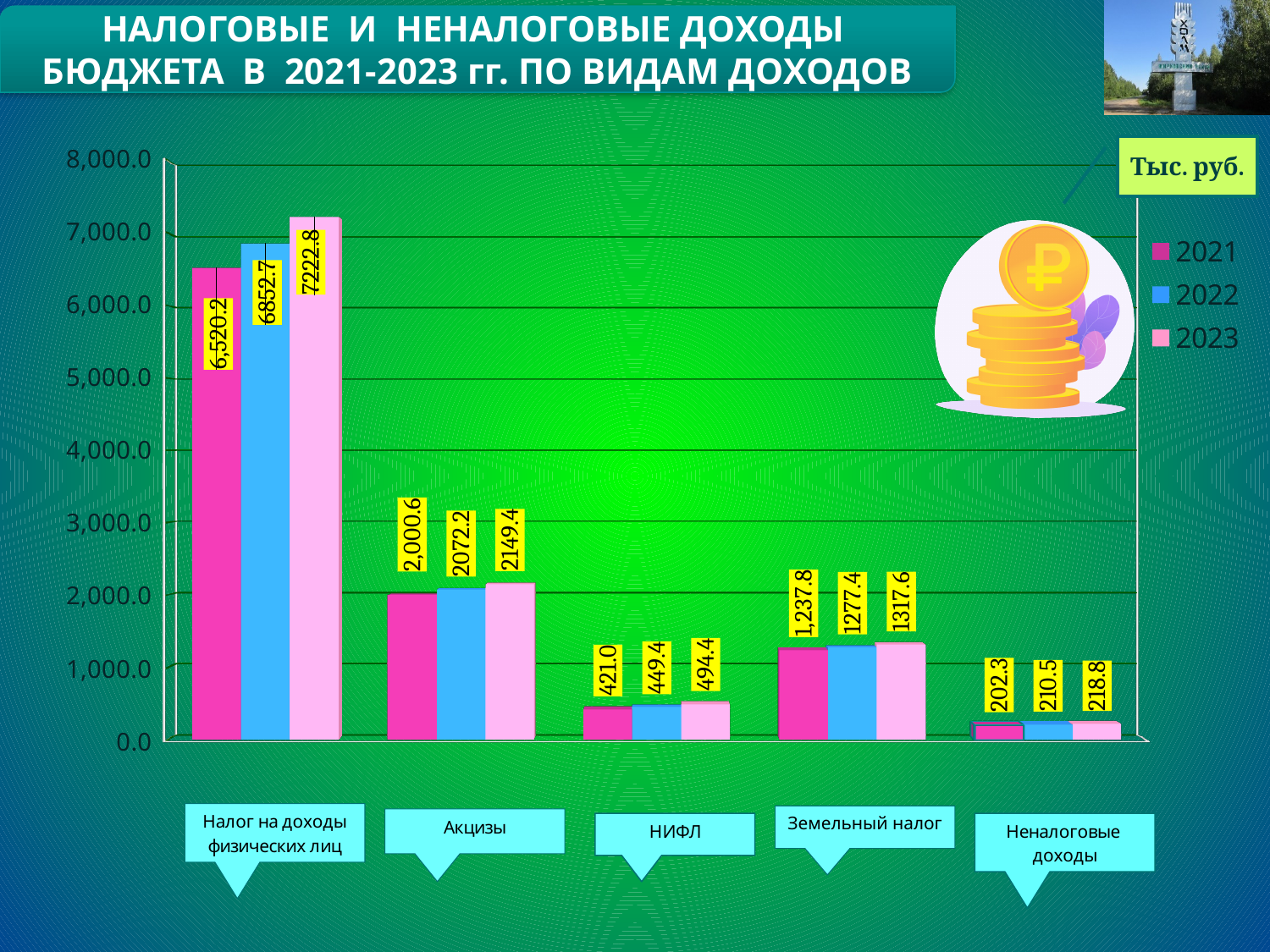
Which category has the lowest value in 2023? Неналоговые доходы How many series does the legend list? 3 What is the value for Неналоговые доходы in 2021? 202.3 How many categories are shown on the x axis? 5 What is the value for Акцизы in 2021? 2,000.6 What is the value for НИФЛ in 2022? 449.4 What is the value for Налог на доходы физических лиц in 2023? 7222.8 Do the values for Неналоговые доходы rise or fall from 2021 to 2023? rise What is the difference between the 2023 and 2021 values for Земельный налог? 79.8 Which category has the highest value in 2022? Налог на доходы физических лиц What is the value for Земельный налог in 2023? 1317.6 Which is larger: the 2022 value for Акцизы or the 2022 value for Земельный налог? Акцизы